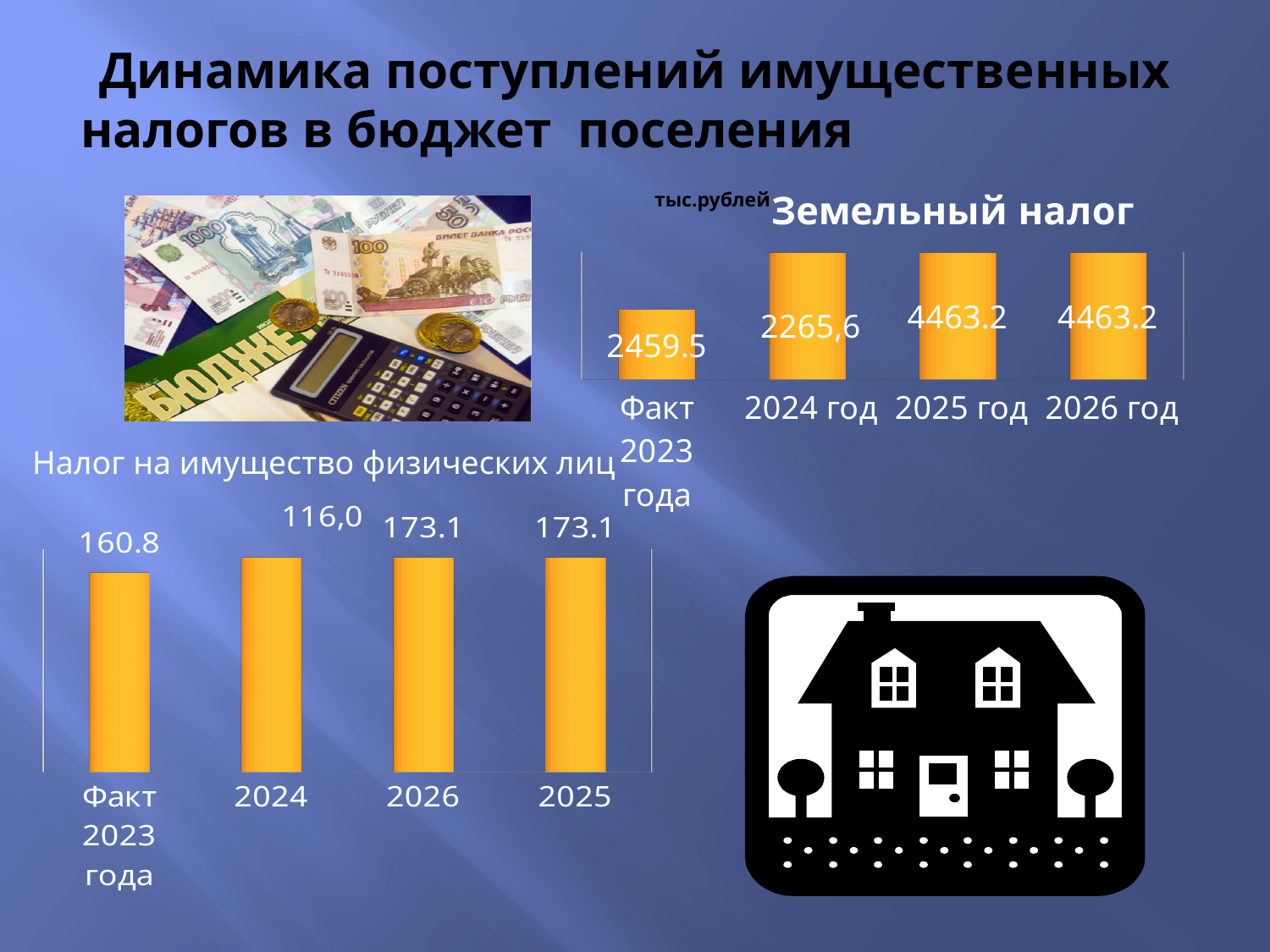
What unit is indicated next to the title of the 'Земельный налог' chart? тыс.рублей In the 'Земельный налог' chart, how many categories are shown? 4 In the 'Земельный налог' chart, what is the difference between the values for 2025 год and Факт 2023 года? 2003.7 In the 'Налог на имущество физических лиц' chart, what is the value for 2026? 173.1 In the 'Налог на имущество физических лиц' chart, what is the difference between the values for 2025 and Факт 2023 года? 12.3 In the 'Налог на имущество физических лиц' chart, how many bars are shown? 4 In the 'Земельный налог' chart, what is the value for Факт 2023 года? 2459.5 In the 'Земельный налог' chart, what is the value for 2024 год? 2265,6 What kind of chart is the 'Земельный налог' chart? bar chart In the 'Налог на имущество физических лиц' chart, what is the value for Факт 2023 года? 160.8 In the 'Земельный налог' chart, what is the value for 2025 год? 4463.2 In the 'Налог на имущество физических лиц' chart, what is the value for 2024? 116,0